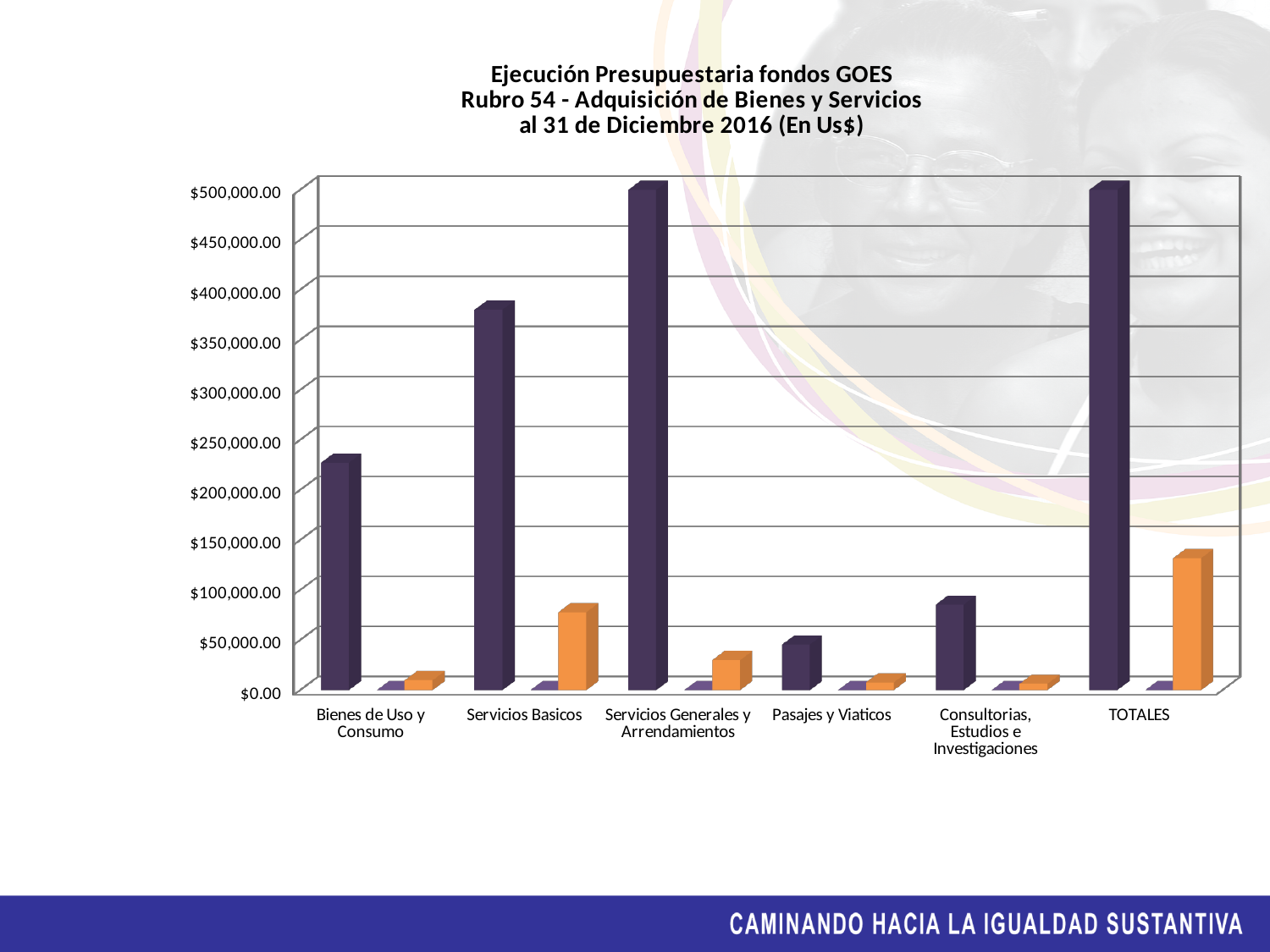
Which has the taller purple bar, Consultorias, Estudios e Investigaciones or Pasajes y Viaticos? Consultorias, Estudios e Investigaciones How many categories are shown along the x axis of the chart? 6 Is the value of the tall purple bar for Pasajes y Viaticos greater or less than $100,000.00? less What kind of chart is shown on the slide? bar chart Is the value of the tall purple bar for Servicios Basicos greater or less than $350,000.00? greater Which category has the lowest tall purple bar? Pasajes y Viaticos Is the value of the orange bar for Servicios Basicos greater or less than $100,000.00? less What is the first line of the chart's title? Ejecución Presupuestaria fondos GOES Which has the taller purple bar, Servicios Basicos or Bienes de Uso y Consumo? Servicios Basicos Which category has the highest orange bar? TOTALES